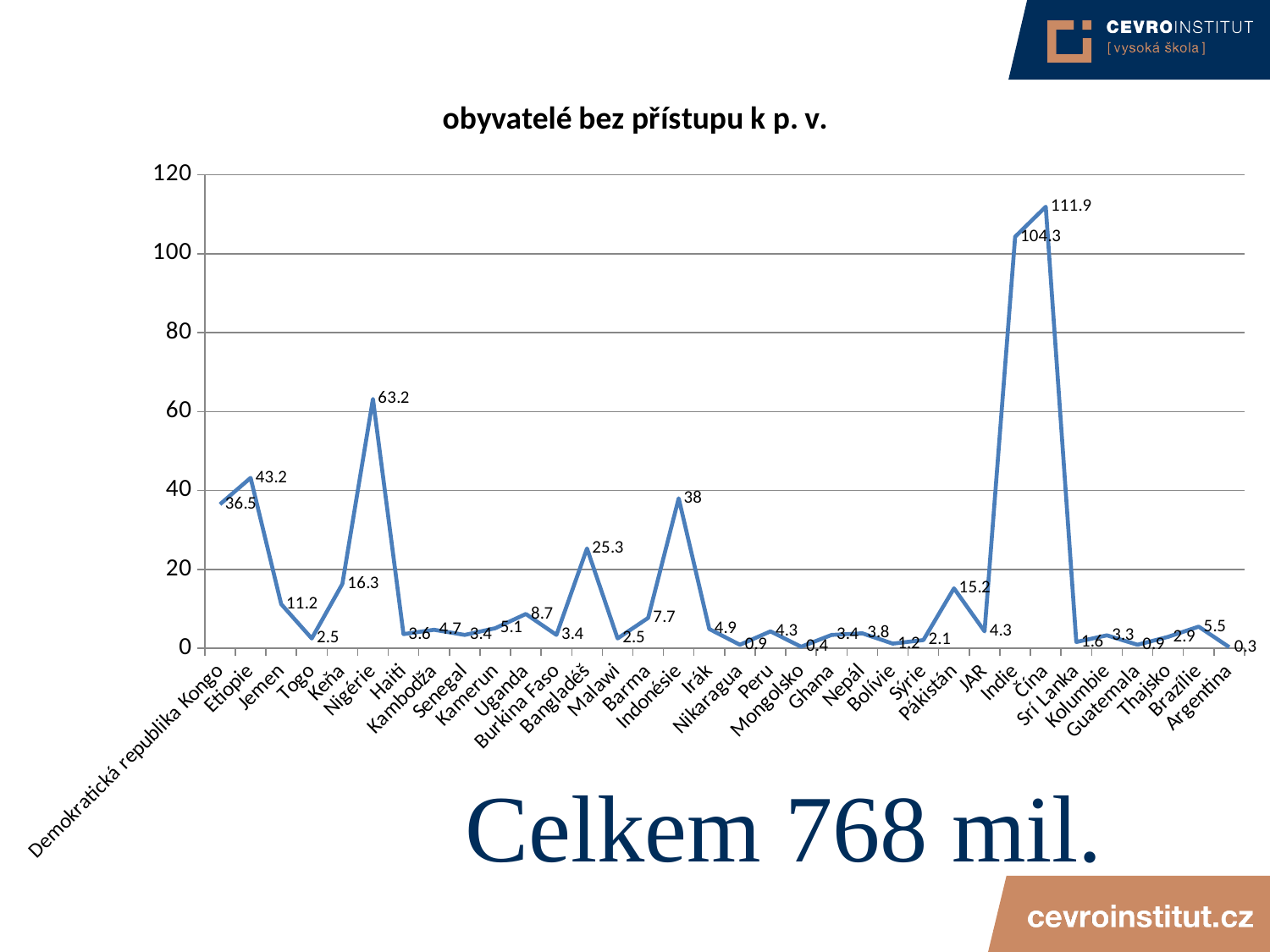
What type of chart is shown on the slide? line chart What is the difference between the values for Čína and Indie? 7.6 What is the title of the chart? obyvatelé bez přístupu k p. v. What is the value for Pákistán? 15.2 What is the difference between the values for Nigérie and Etiopie? 20 What is the value for Nigérie? 63.2 What is the value for Bangladéš? 25.3 Which country has the lowest value? Argentina Which has a larger value, Indonésie or Etiopie? Etiopie Which country has the highest value? Čína What is the value for Indie? 104.3 How many countries are plotted on the chart? 34